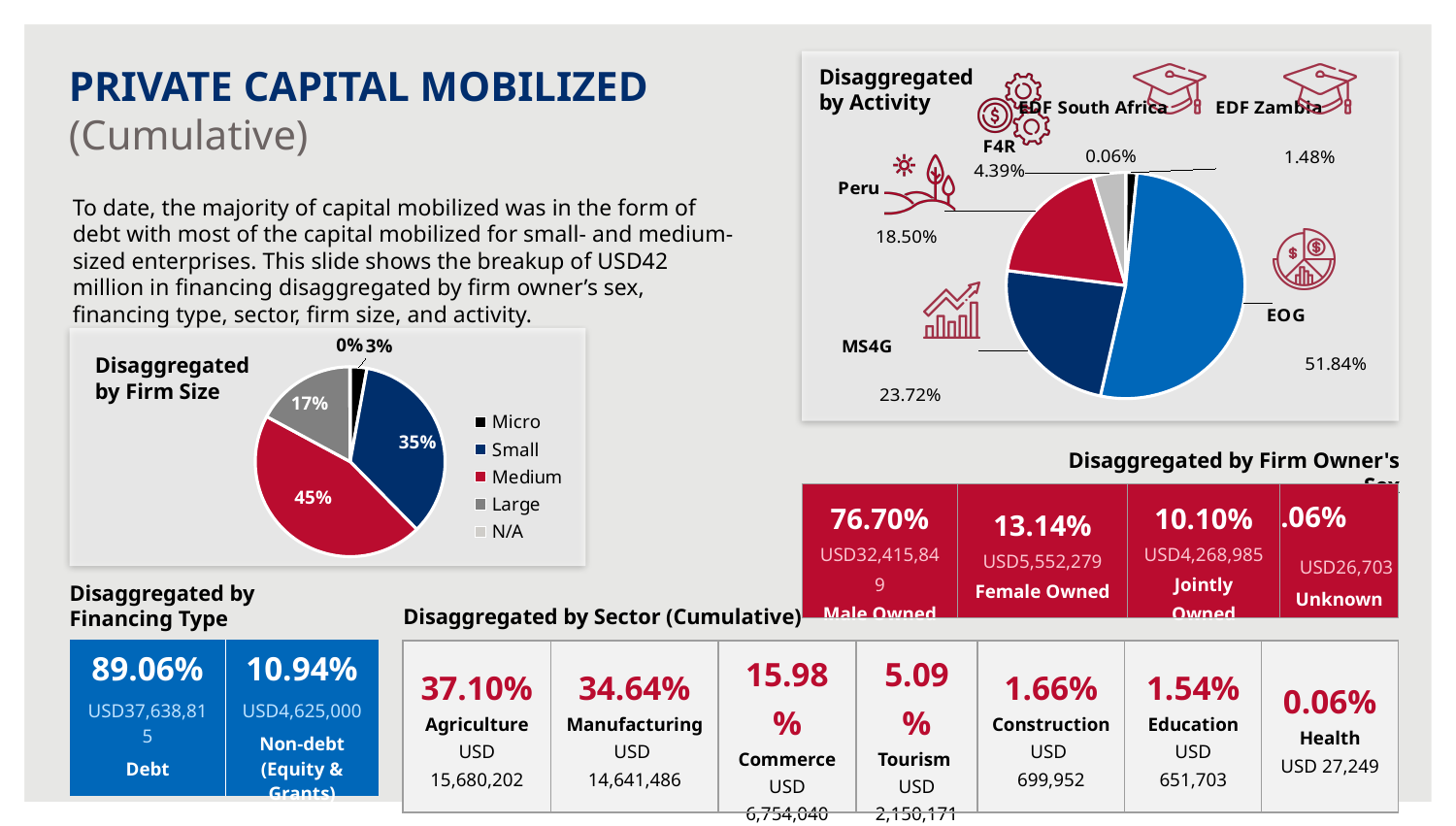
How many entries does the legend of the 'Disaggregated by Firm Size' pie chart list? 5 In the 'Disaggregated by Firm Size' pie chart, what is the difference in percentage points between the Medium and Large shares? 28 In the 'Disaggregated by Activity' pie chart, which is larger, the share for Peru or the share for F4R? Peru In the 'Disaggregated by Activity' pie chart, what percentage is labelled for MS4G? 23.72% In the 'Disaggregated by Firm Size' pie chart, what share is labelled for Medium firms? 45% In the 'Disaggregated by Activity' pie chart, what percentage is labelled for EOG? 51.84% What type of chart is used for 'Disaggregated by Firm Size'? Pie chart In the 'Disaggregated by Firm Size' pie chart, what share is labelled for Small firms? 35% In the 'Disaggregated by Firm Size' pie chart, which firm size category has the smallest share? N/A How many slices does the 'Disaggregated by Activity' pie chart have? 6 In the 'Disaggregated by Activity' pie chart, which activity has the smallest share? EDF South Africa In the 'Disaggregated by Firm Size' pie chart, which firm size category has the largest share? Medium